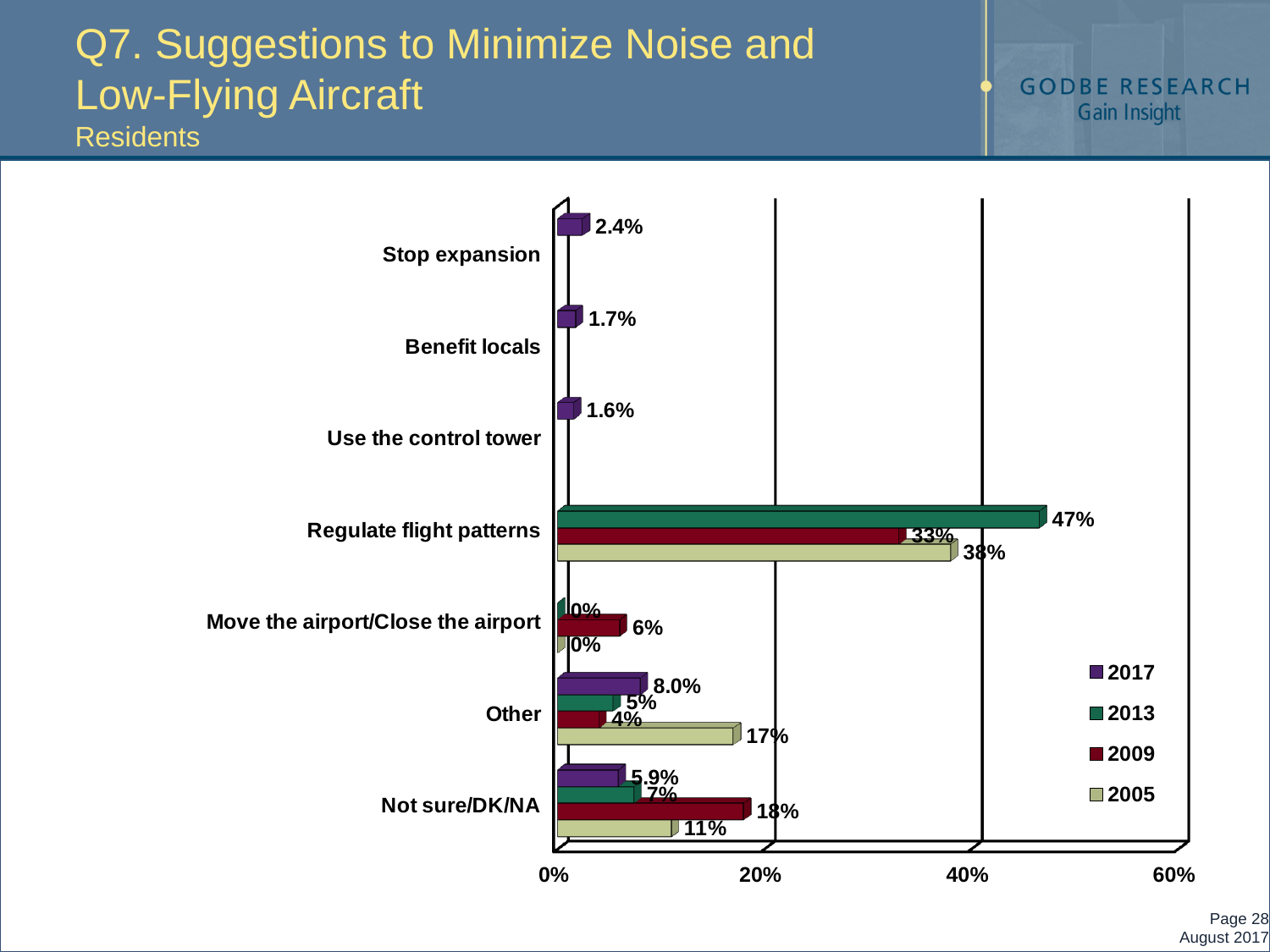
What is the 2009 value for Not sure/DK/NA? 18% Which years are listed in the chart legend? 2017, 2013, 2009, 2005 What is the 2013 value for Regulate flight patterns? 47% How many series does the legend list? 4 What is the difference between the 2013 and 2009 values for Regulate flight patterns? 14 percentage points For Other, which year has the larger value, 2005 or 2017? 2005 What kind of chart is shown on the slide? Bar chart What is the 2017 value for Stop expansion? 2.4% What is the 2005 value for Other? 17% Which category has the highest 2017 value? Other Is the 2013 value for Regulate flight patterns greater or less than 40%? greater How many suggestion categories are shown on the chart? 7